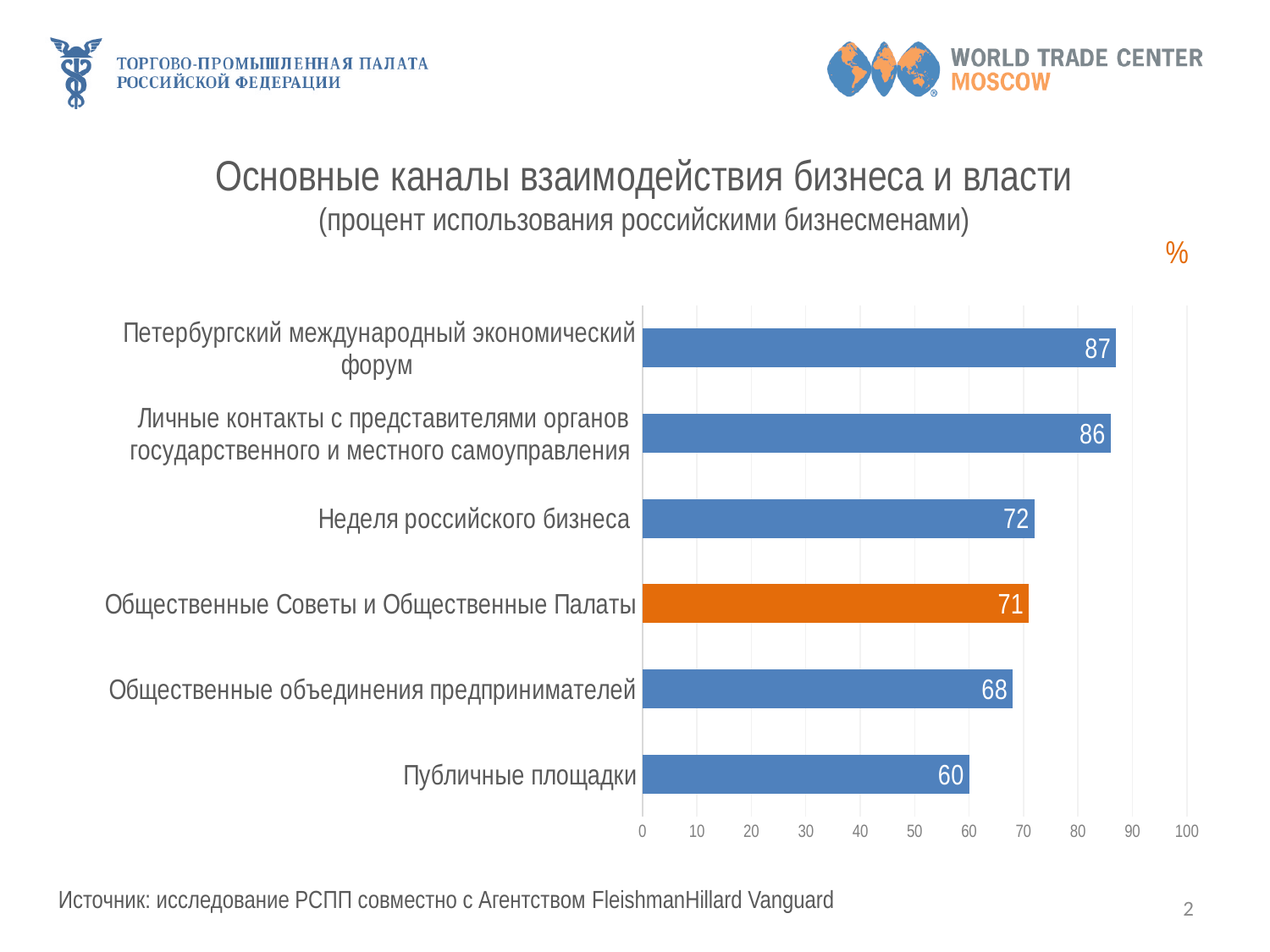
What is the value for Неделя российского бизнеса? 72 What is the difference between the values for Личные контакты с представителями органов государственного и местного самоуправления and Общественные объединения предпринимателей? 18 What is the value for Петербургский международный экономический форум? 87 What is the value for Общественные Советы и Общественные Палаты? 71 What kind of chart is shown on the slide? bar chart Which category's bar is coloured orange instead of blue? Общественные Советы и Общественные Палаты Which category has the highest value? Петербургский международный экономический форум Is the value for Общественные объединения предпринимателей greater or less than 50? greater How many categories are shown in the chart? 6 Which category has the lowest value? Публичные площадки Which is larger: the value for Неделя российского бизнеса or the value for Публичные площадки? Неделя российского бизнеса What is the value for Публичные площадки? 60